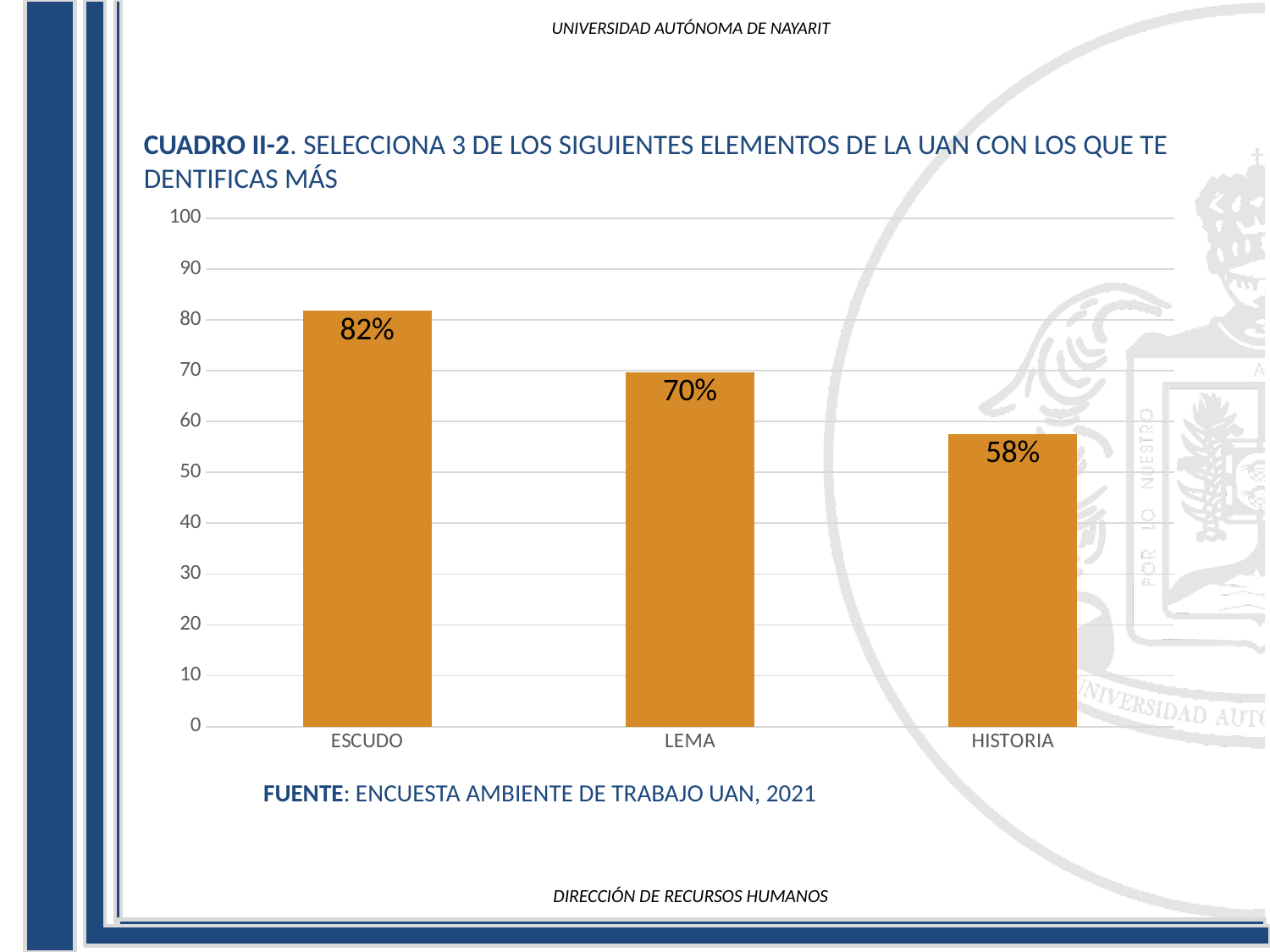
Which category has the lowest value? HISTORIA Which is larger, the value for LEMA or the value for HISTORIA? LEMA What kind of chart is shown on the slide? bar chart What is the value for HISTORIA? 58% Is the value for LEMA greater or less than 60? greater What is the value for LEMA? 70% What is the difference between the values for LEMA and HISTORIA? 12% What is the difference between the values for ESCUDO and HISTORIA? 24% Which category has the highest value? ESCUDO What is the value for ESCUDO? 82% How many categories are shown on the x axis? 3 Do the values rise or fall from left to right along the x axis? fall